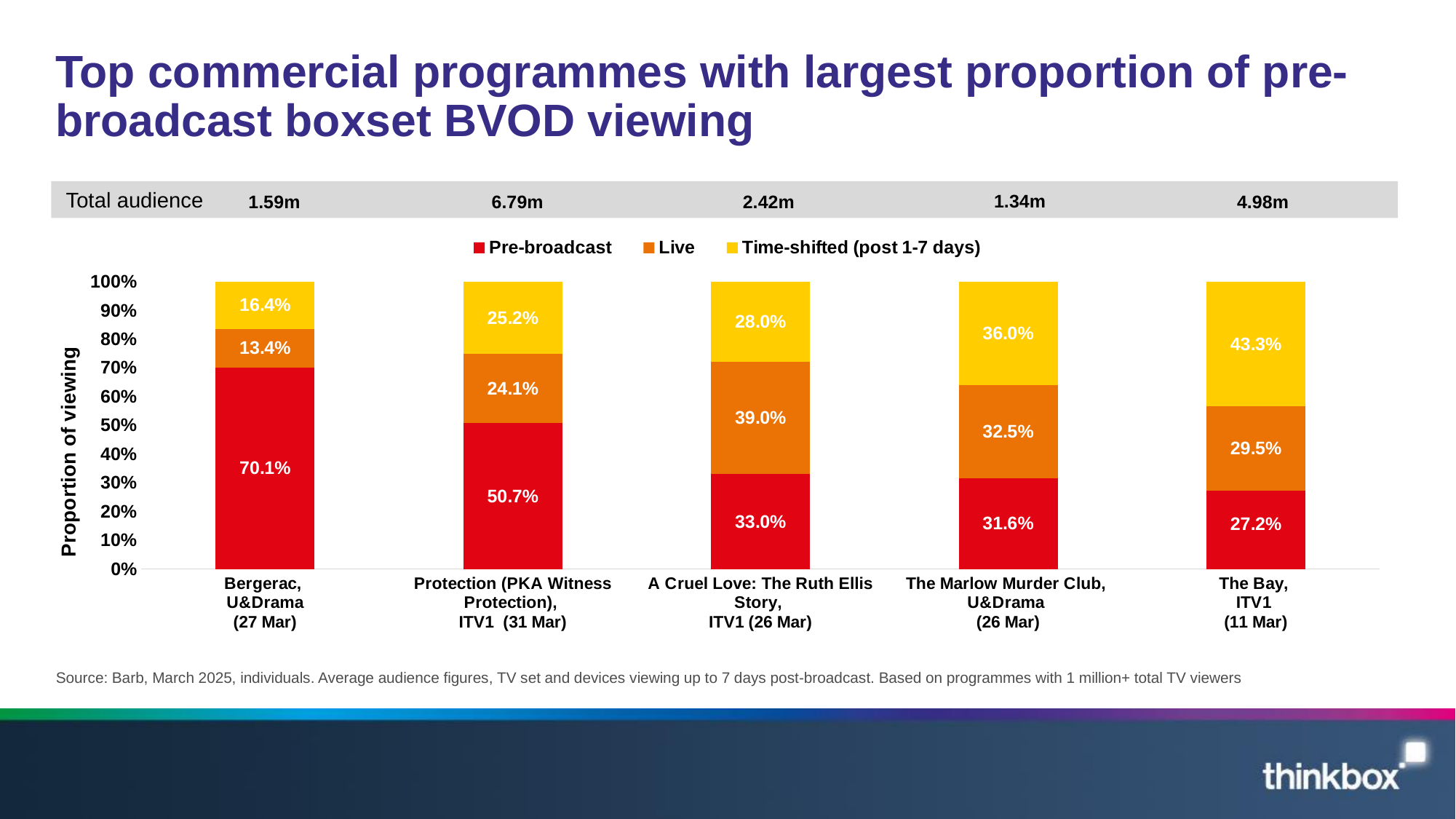
Does the Pre-broadcast share rise or fall moving from left to right across the programmes? Fall Which is larger: the Live share for The Marlow Murder Club or the Live share for The Bay? The Marlow Murder Club What is the Time-shifted (post 1-7 days) share of viewing for The Bay? 43.3% What is the total audience shown for Protection (PKA Witness Protection)? 6.79m What is the difference between the Pre-broadcast shares for Protection (PKA Witness Protection) and The Marlow Murder Club? 19.1 percentage points What kind of chart is shown on the slide? Stacked bar chart Which programme has the lowest Time-shifted (post 1-7 days) share of viewing? Bergerac How many programmes are shown on the chart? 5 How many series does the legend list? 3 What is the Live share of viewing for A Cruel Love: The Ruth Ellis Story? 39.0% Which programme has the highest Pre-broadcast share of viewing? Bergerac What is the Pre-broadcast share of viewing for Bergerac? 70.1%